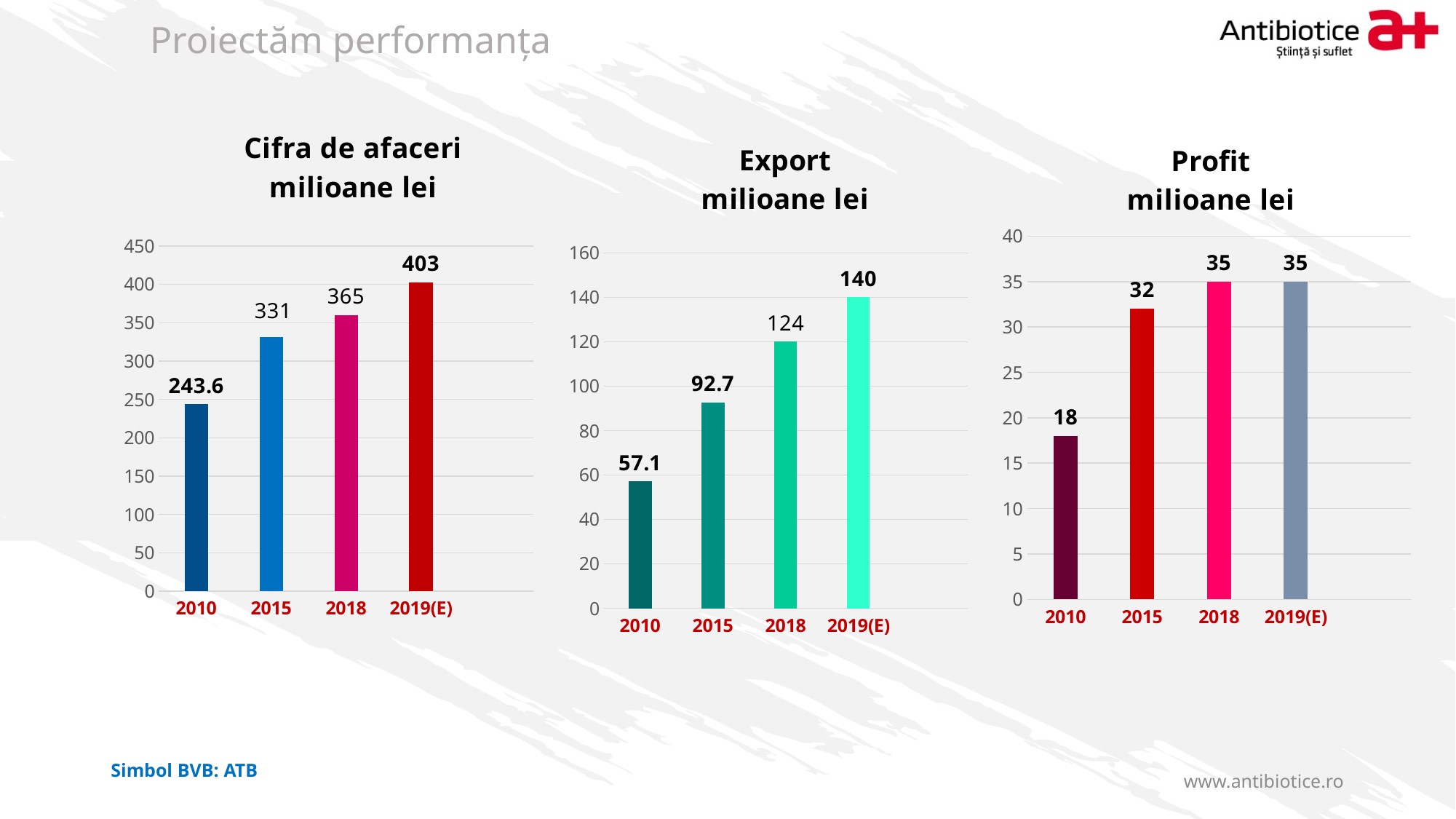
In the 'Cifra de afaceri milioane lei' chart, which year has the highest value? 2019(E) In the 'Cifra de afaceri milioane lei' chart, what is the difference between the 2019(E) and 2018 values? 38 In the 'Profit milioane lei' chart, what is the value for 2010? 18 What kind of chart is the 'Export milioane lei' chart? Bar chart In the 'Cifra de afaceri milioane lei' chart, what is the value for 2019(E)? 403 In the 'Export milioane lei' chart, which year has the lowest value? 2010 In the 'Export milioane lei' chart, what is the value for 2015? 92.7 How many bars are in the 'Profit milioane lei' chart? 4 In the 'Export milioane lei' chart, what is the difference between the 2018 and 2015 values? 31.3 In the 'Cifra de afaceri milioane lei' chart, do the values rise or fall from 2010 to 2019(E)? Rise In the 'Cifra de afaceri milioane lei' chart, what is the value for 2010? 243.6 In the 'Profit milioane lei' chart, which is larger, the value for 2015 or the value for 2010? 2015